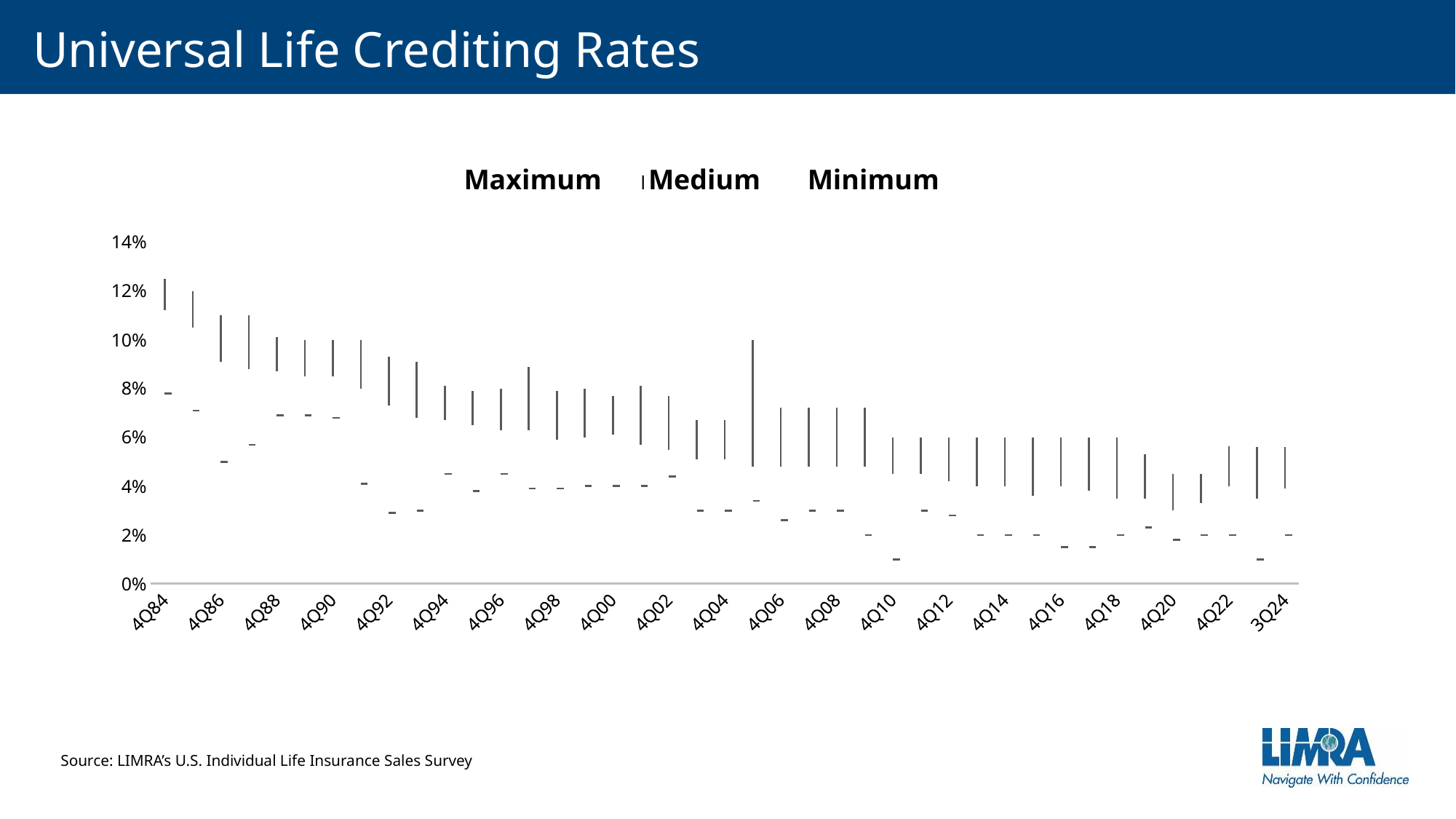
Do the Maximum crediting rates generally rise or fall from 4Q84 to 3Q24? fall What are the three series named in the legend? Maximum, Medium, Minimum Is the Maximum value for 3Q24 greater or less than 4%? greater What is the title of the chart? Universal Life Crediting Rates Is the Maximum value for 4Q92 greater or less than 8%? greater Which is larger, the Maximum value for 4Q84 or the Maximum value for 3Q24? 4Q84 Is the Minimum value for 4Q92 greater or less than 4%? less How many series does the legend list? 3 How many period labels are shown on the x axis? 21 Which period has the highest Maximum crediting rate? 4Q84